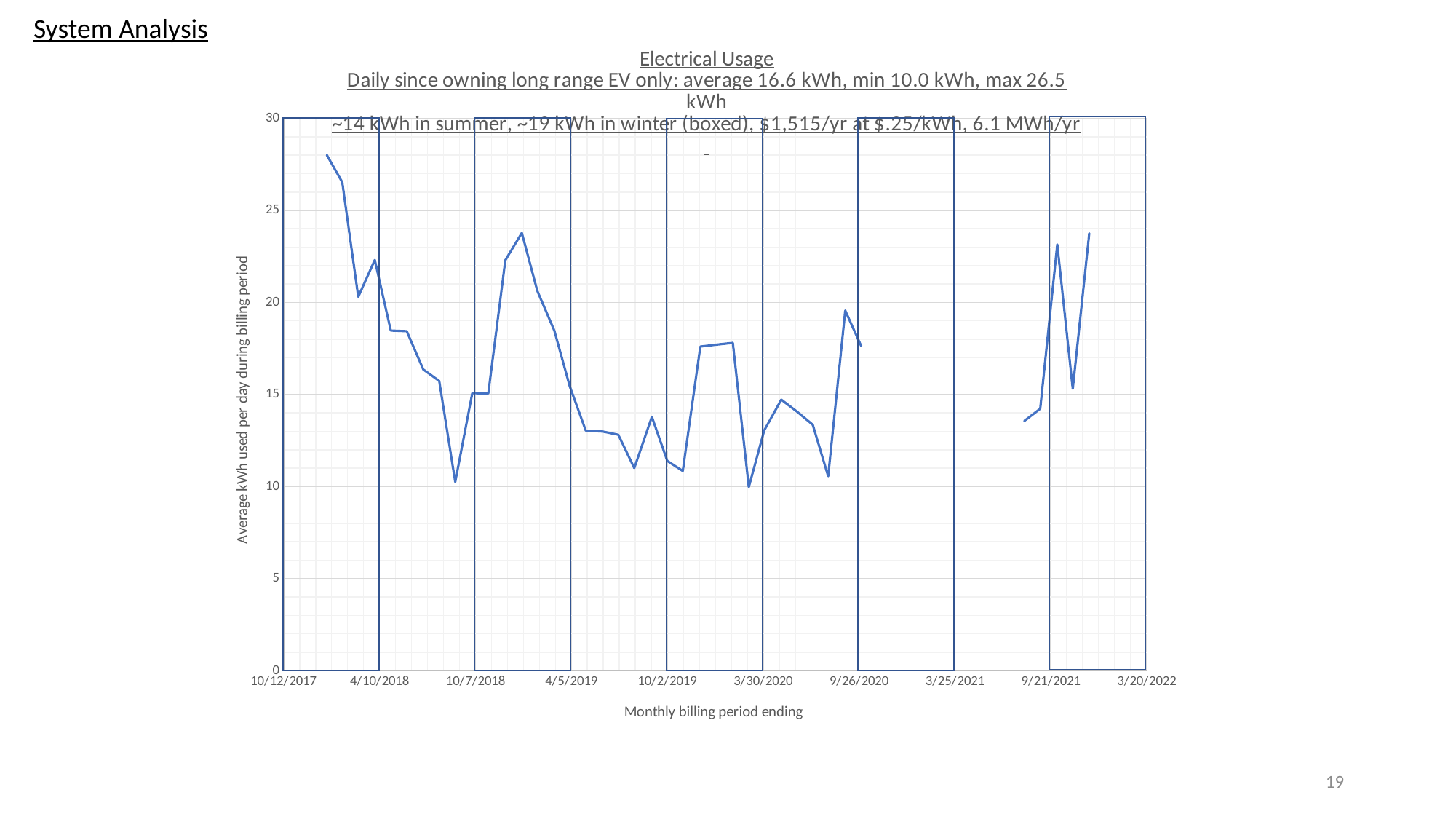
Which is larger, the value at 3/30/2020 or the value at 9/26/2020? 9/26/2020 What is the title of the y axis of the chart? Average kWh used per day during billing period Is the value at 3/30/2020 greater or less than 15? less Is the value at 10/7/2018 greater or less than 10? greater Is the highest point on the line greater or less than 25? greater What kind of chart is shown on the slide? line chart Does the highest value on the line occur near the beginning or near the end of the series? near the beginning According to the chart title, what is the average daily electrical usage since owning the long range EV only? 16.6 kWh Do the values rise or fall from the first point of the series to 10/7/2018? fall